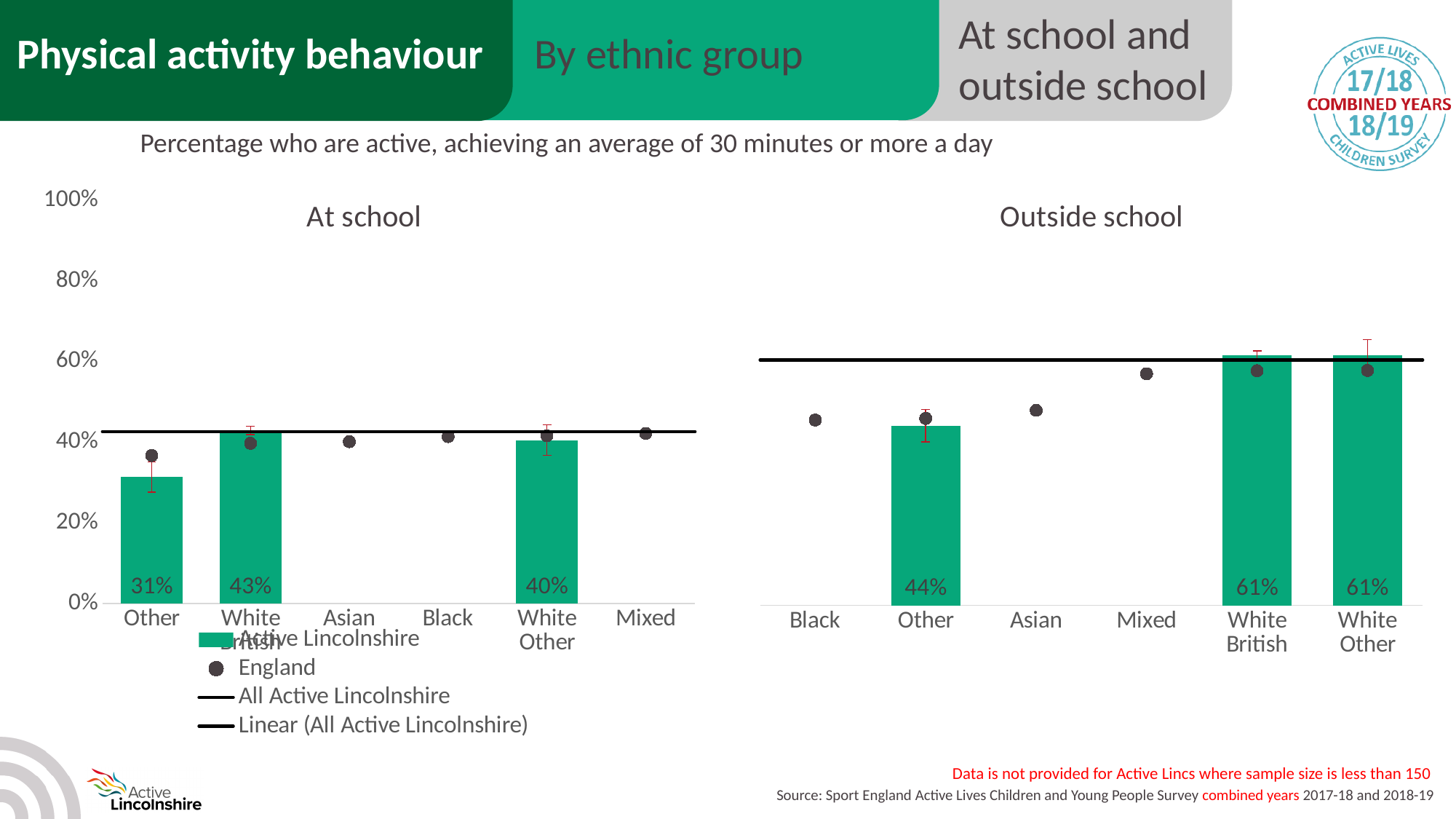
In the Outside school chart, what is the difference between the Active Lincolnshire values for White British and Other? 17 percentage points How many ethnic group categories are shown on the x axis of the At school chart? 6 In the At school chart, which is larger, the Active Lincolnshire value for White British or for White Other? White British In the Outside school chart, what is the Active Lincolnshire value for the Other ethnic group? 44% In the At school chart, what is the Active Lincolnshire value for the Other ethnic group? 31% In the Outside school chart, which ethnic group has the lowest Active Lincolnshire bar? Other In the At school chart, what is the Active Lincolnshire value for White British? 43% In the Outside school chart, is the England value for Black greater or less than 60%? less In the At school chart, what is the difference between the Active Lincolnshire values for White British and Other? 12 percentage points In the At school chart, which ethnic group has the highest Active Lincolnshire bar? White British In the At school chart, which ethnic group has the lowest Active Lincolnshire bar? Other In the Outside school chart, what is the Active Lincolnshire value for White British? 61%